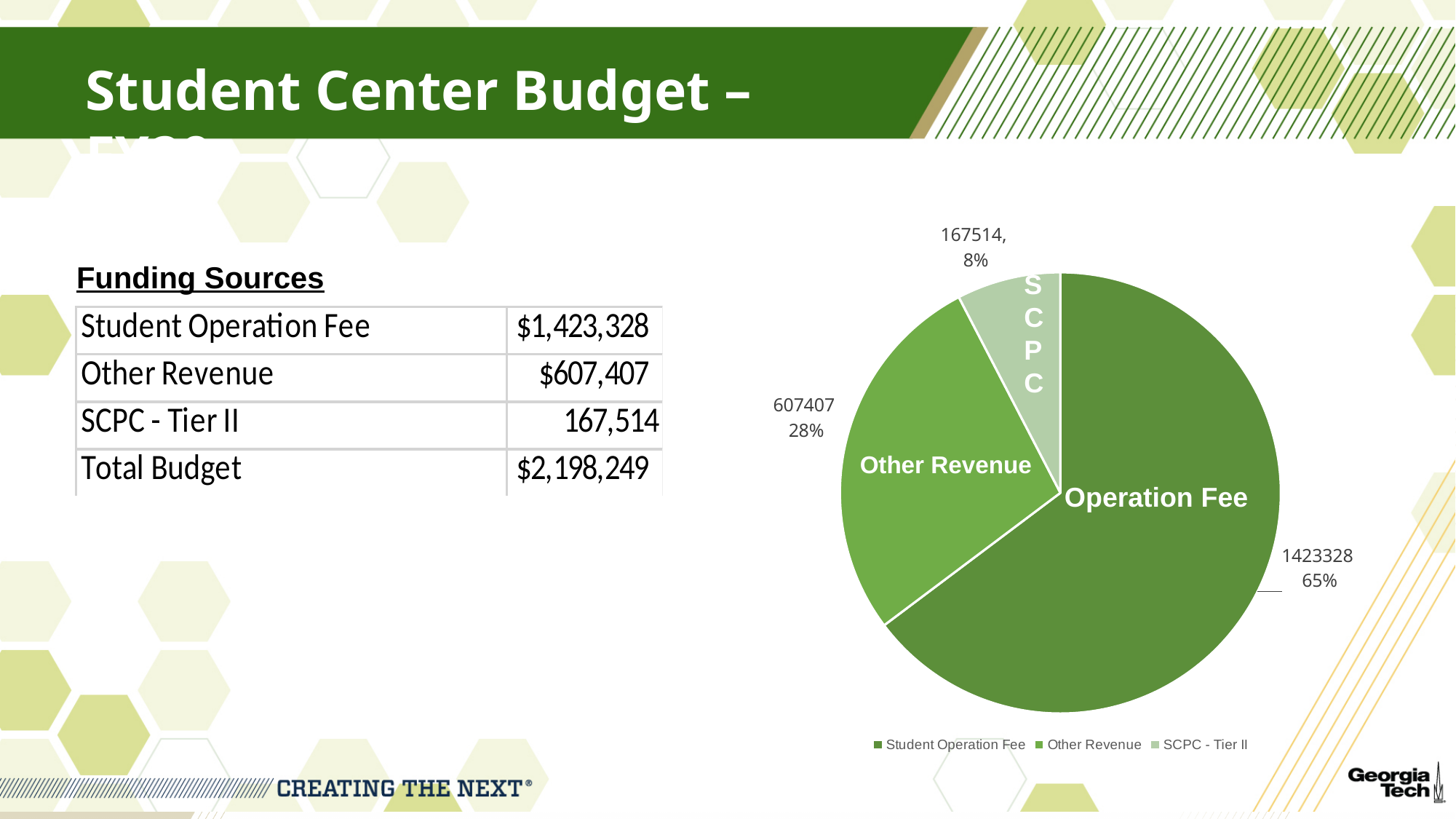
Which slice of the pie chart is the smallest? SCPC - Tier II Which is larger in the pie chart, Other Revenue or SCPC - Tier II? Other Revenue How many entries does the pie chart's legend list? 3 What value is labelled on the Student Operation Fee slice of the pie chart? 1423328 Which slice of the pie chart is the largest? Student Operation Fee What share of the pie does SCPC - Tier II represent? 8% What kind of chart is shown on the slide? pie chart What value is labelled on the Other Revenue slice of the pie chart? 607407 What is the difference between the Student Operation Fee value and the Other Revenue value in the pie chart? 815921 What value is labelled on the SCPC - Tier II slice of the pie chart? 167514 What share of the pie does Other Revenue represent? 28% How many slices does the pie chart have? 3